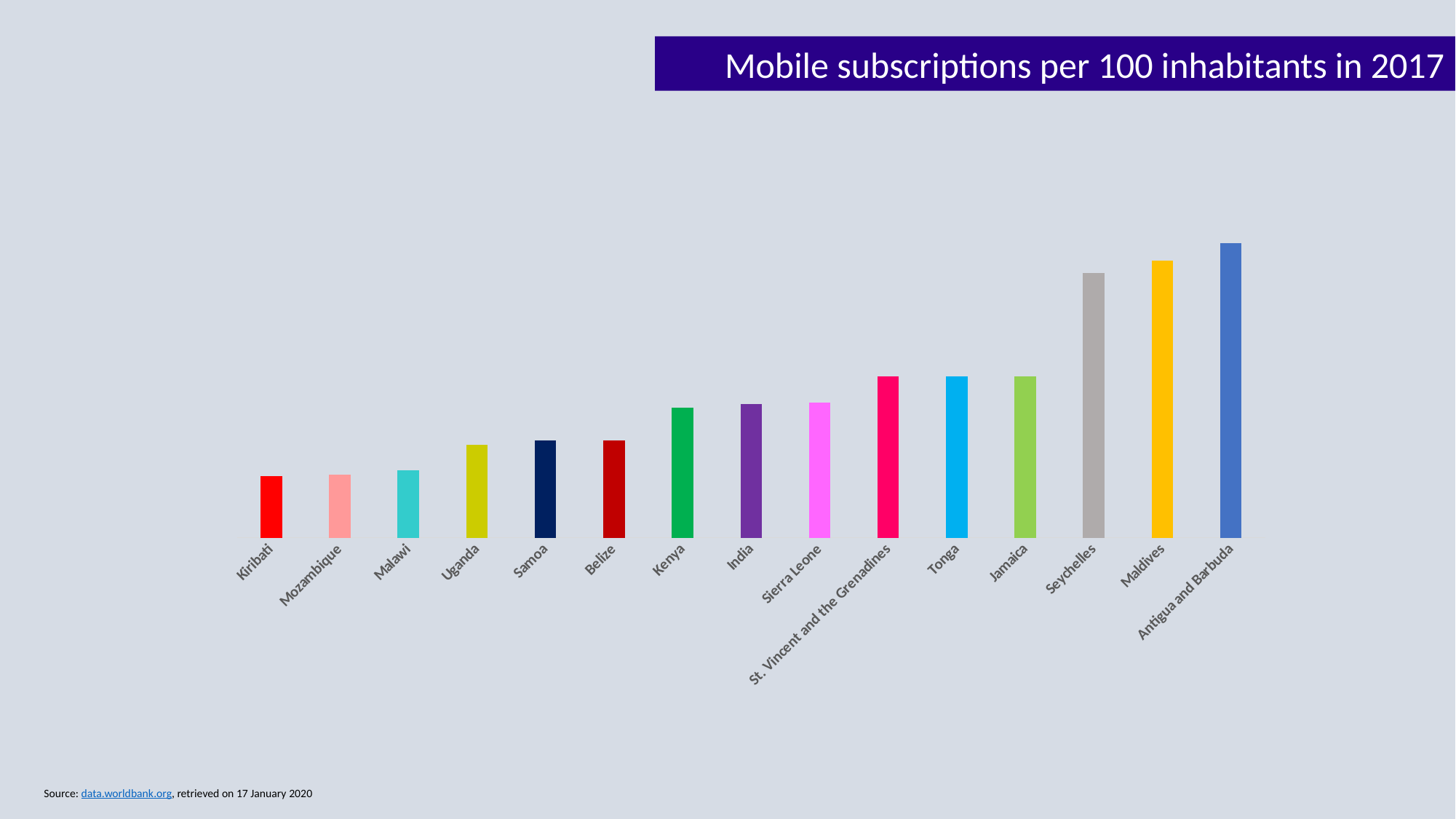
Which has more mobile subscriptions per 100 inhabitants, Maldives or Antigua and Barbuda? Antigua and Barbuda Which has more mobile subscriptions per 100 inhabitants, Seychelles or Jamaica? Seychelles What kind of chart is shown on the slide? bar chart What is the title of the chart? Mobile subscriptions per 100 inhabitants in 2017 Which has more mobile subscriptions per 100 inhabitants, India or Malawi? India Which of the three countries Seychelles, Maldives and Antigua and Barbuda has the lowest value? Seychelles Do the bar values rise or fall from left to right across the chart? rise Which country has the highest number of mobile subscriptions per 100 inhabitants in the chart? Antigua and Barbuda What is the source of the data cited on the slide? data.worldbank.org How many countries are shown in the chart? 15